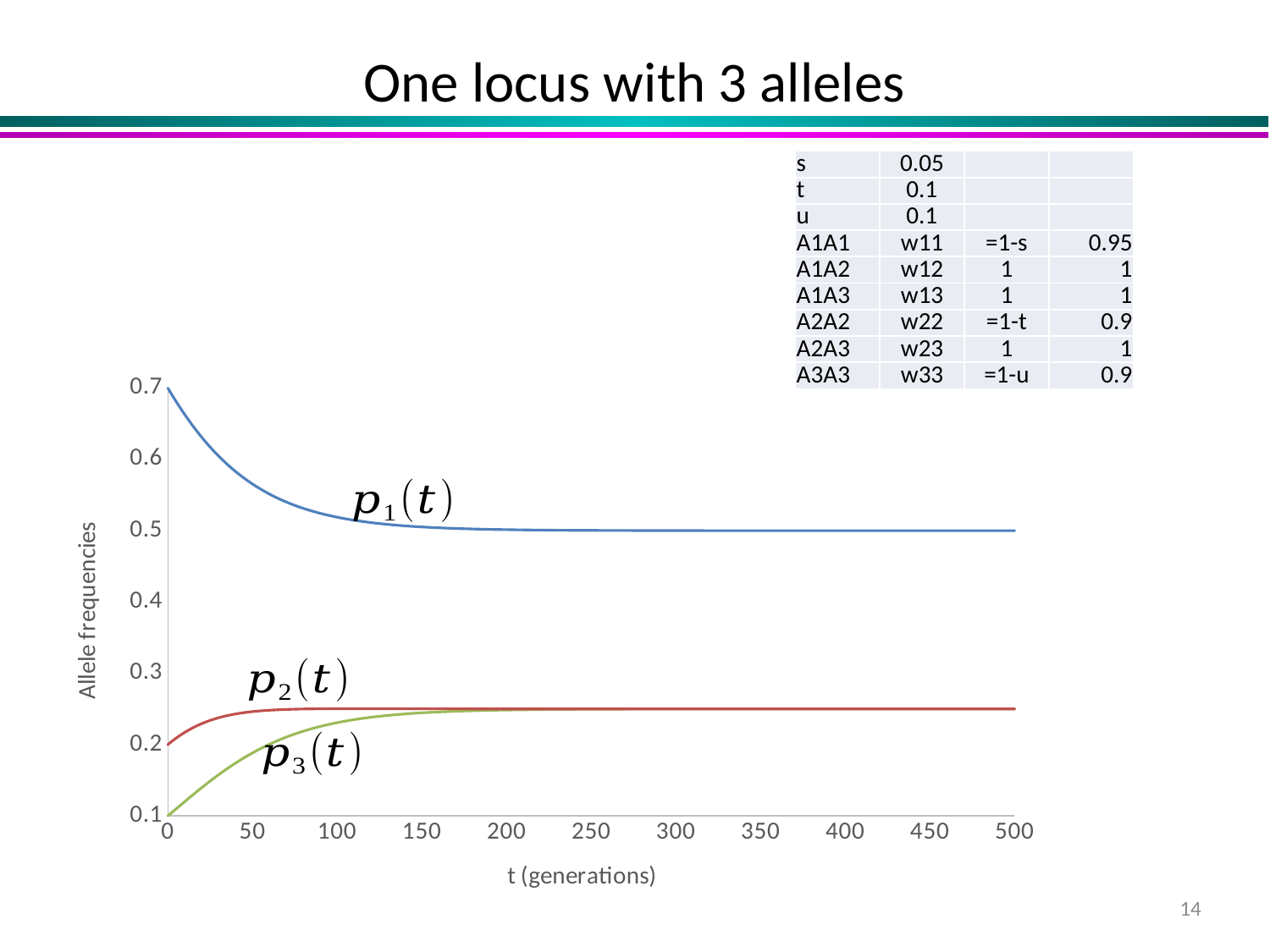
What is the value of p3(t) at t = 0? 0.1 What is the label of the vertical axis of the chart? Allele frequencies Is the value of p1(t) at t = 500 greater or less than 0.6? less Is the value of p3(t) at t = 500 greater or less than 0.2? greater What is the value of p2(t) at t = 0? 0.2 What kind of chart is shown on the slide? line chart Does p1(t) rise or fall as t increases from 0? fall Which curve has the highest value at t = 0? p1(t) What is the value of p1(t) at t = 0? 0.7 How many curves (series) are plotted on the chart? 3 Which curve has the lowest value at t = 0? p3(t) Does p3(t) rise or fall as t increases from 0? rise